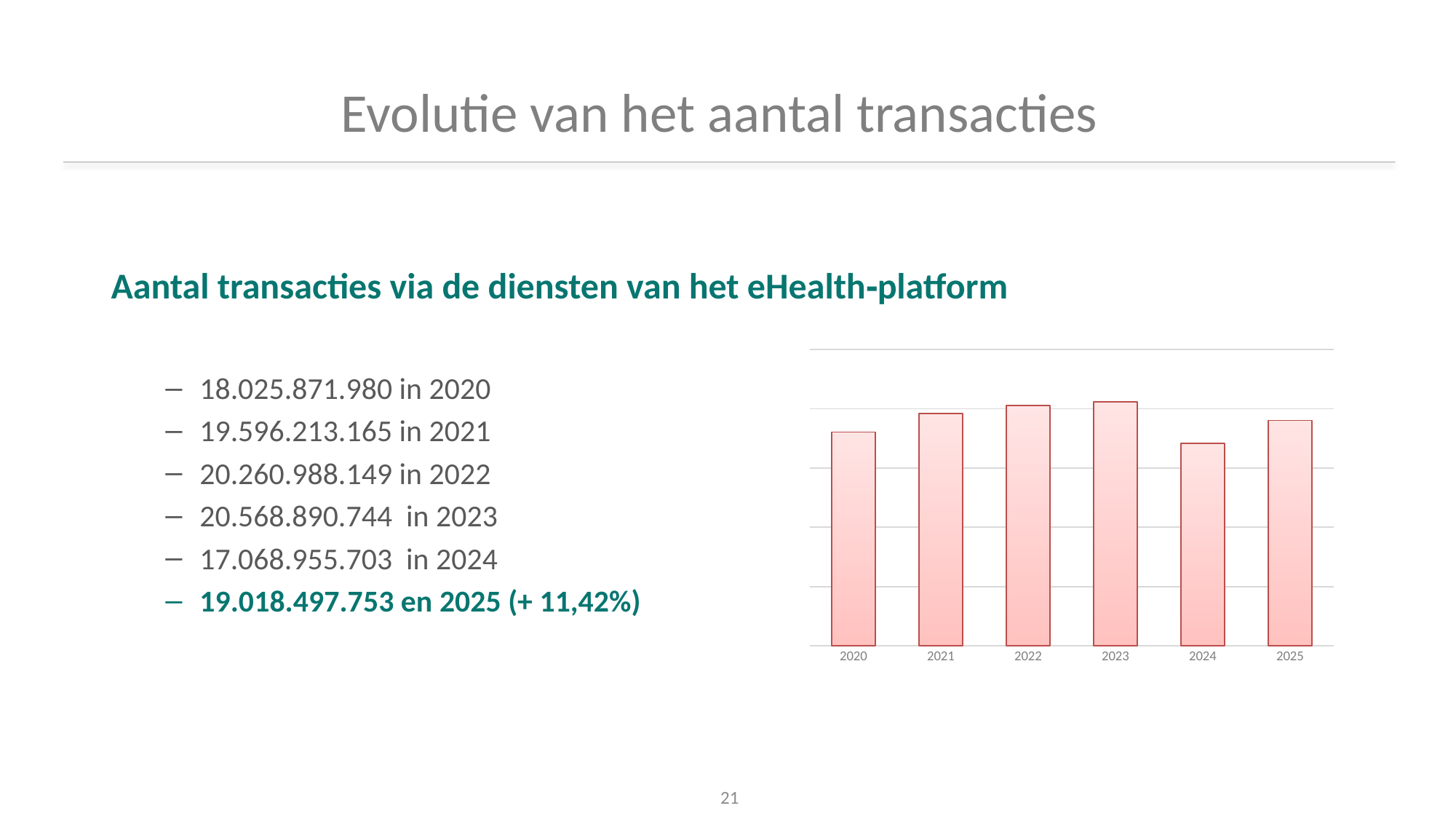
What kind of chart is shown on the slide? bar chart What percentage change is given on the slide for 2025? + 11,42% Does the value fall or rise from 2023 to 2024? fall Which year has the lowest bar in the chart? 2024 According to the slide, what is the number of transactions in 2024? 17.068.955.703 What is the heading above the chart and the list of values? Aantal transacties via de diensten van het eHealth-platform How many years (categories) are shown on the x axis of the chart? 6 Do the bars rise or fall from 2020 to 2023? rise Is the bar for 2021 taller or shorter than the bar for 2025? taller According to the slide, what is the number of transactions in 2023? 20.568.890.744 Which bar is taller, 2020 or 2025? 2025 Which year has the highest bar in the chart? 2023